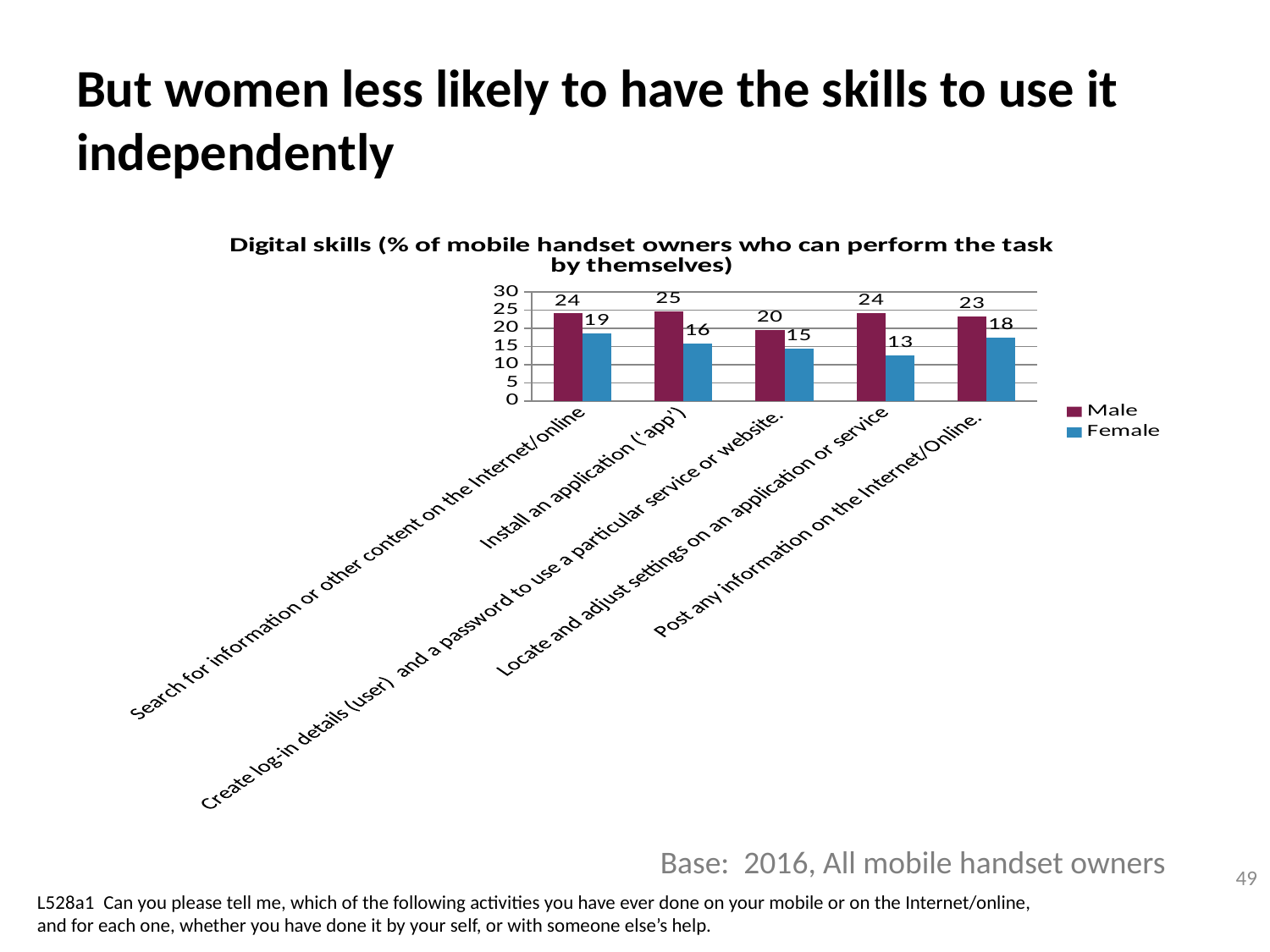
What is the Female value for 'Locate and adjust settings on an application or service'? 13 Which is larger for 'Post any information on the Internet/Online.': the Male value or the Female value? Male What kind of chart is shown on the slide? Bar chart How many categories are shown on the x axis? 5 What is the Female value for 'Search for information or other content on the Internet/online'? 19 Which category has the highest Male value? Install an application ('app') Which category has the lowest Female value? Locate and adjust settings on an application or service What is the Male value for 'Create log-in details (user) and a password to use a particular service or website.'? 20 What is the Male value for 'Install an application ('app')'? 25 What is the difference between the Male and Female values for 'Locate and adjust settings on an application or service'? 11 Which series is shown in blue in the legend? Female How many series does the legend list? 2